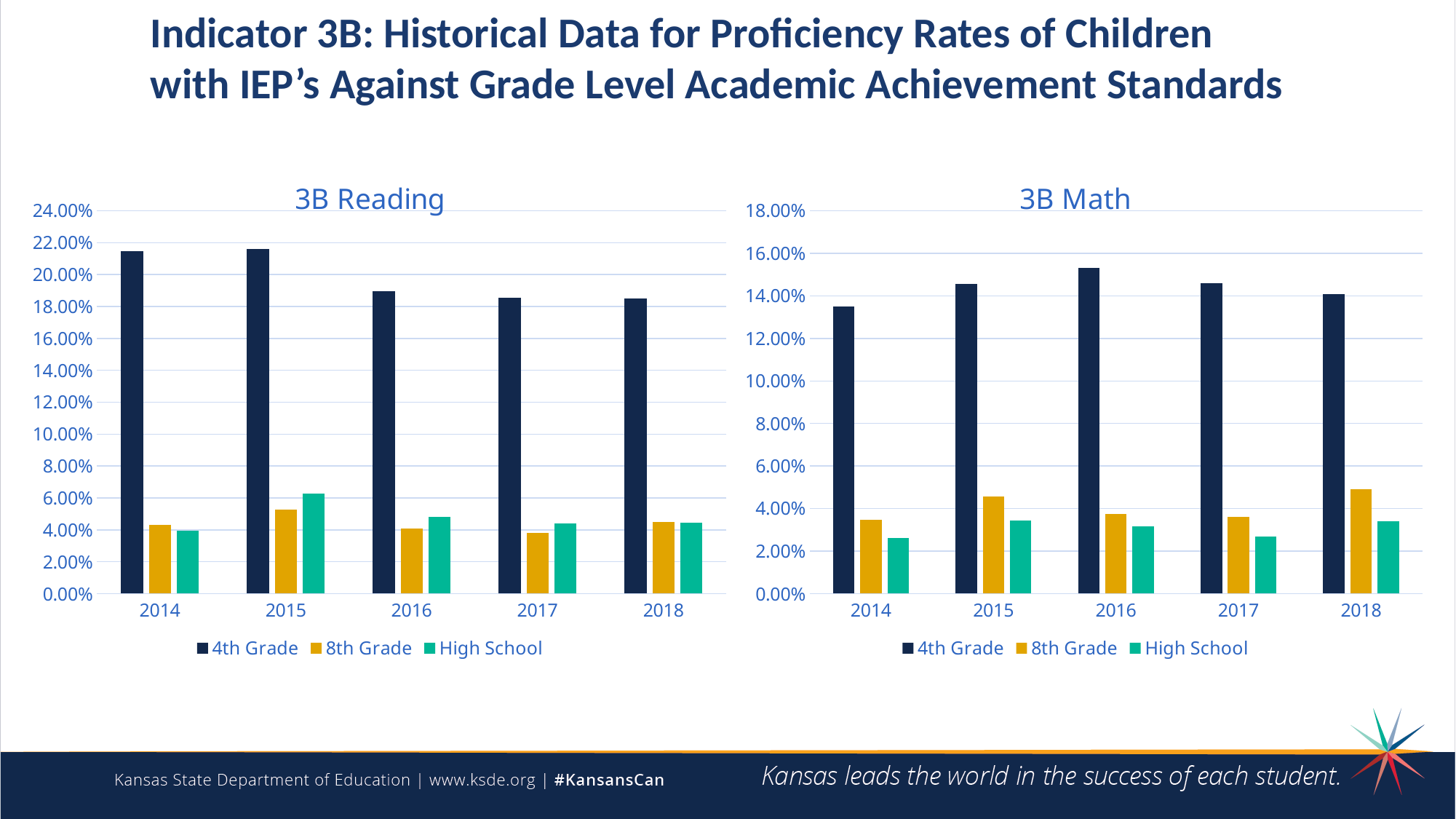
In the 3B Reading chart, which year has the lowest 8th Grade value? 2017 In the 3B Math chart, is the 8th Grade value for 2015 greater or less than 4.00%? greater In the 3B Math chart, for 2014, which is larger: the 8th Grade value or the High School value? 8th Grade In the 3B Reading chart, which year has the highest High School value? 2015 In the 3B Reading chart, for 2015, which is larger: the 8th Grade value or the High School value? High School In the 3B Reading chart, is the 4th Grade value larger in 2016 or in 2018? 2016 How many years are shown on the x axis of the 3B Math chart? 5 In the 3B Math chart, is the 4th Grade value for 2014 greater or less than 14.00%? less In the 3B Reading chart, is the 4th Grade value for 2014 greater or less than 20.00%? greater How many series does the legend of the 3B Reading chart list? 3 What kind of chart is the 3B Reading chart? bar chart In the 3B Math chart, which year has the highest 4th Grade value? 2016